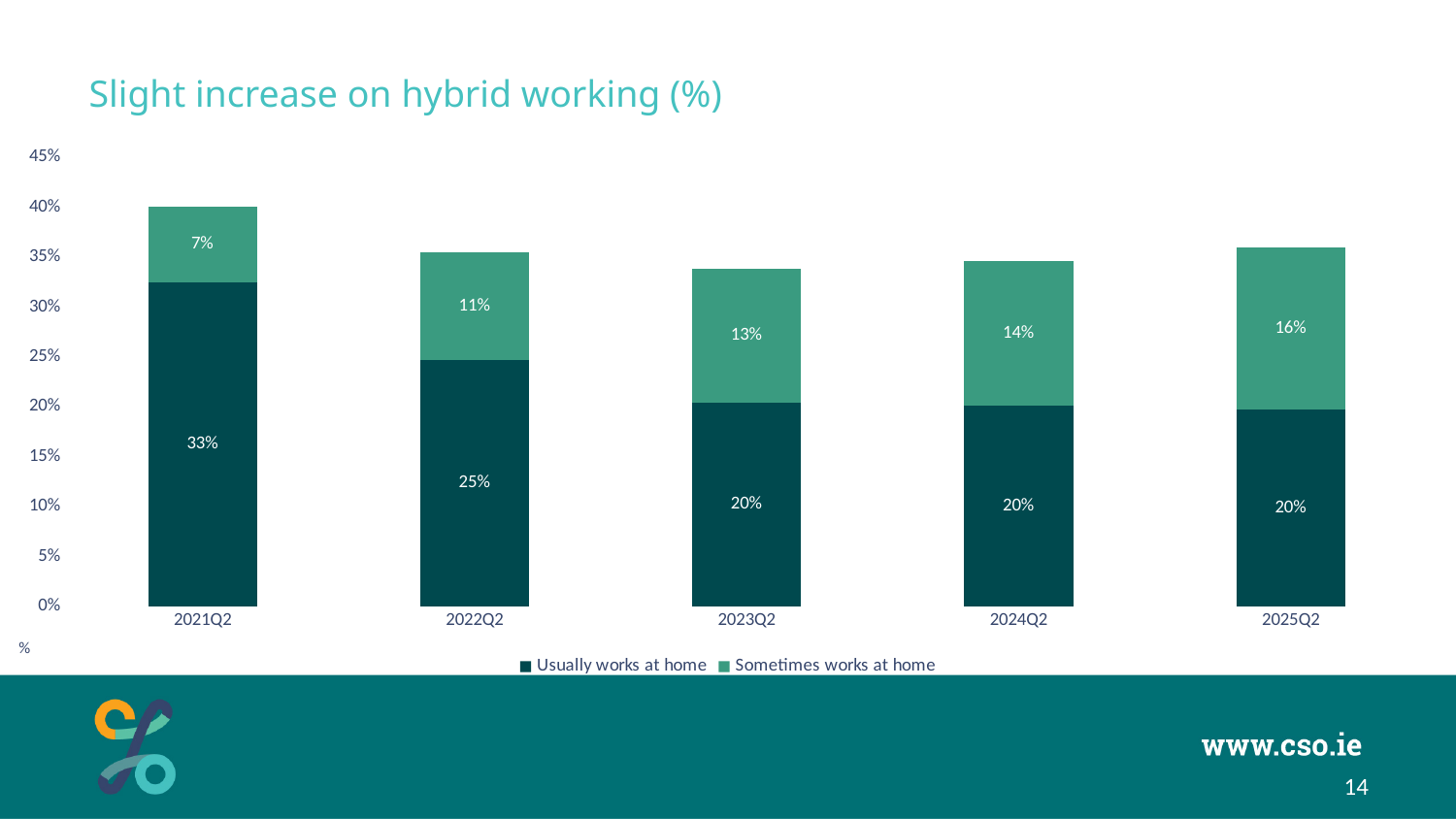
Which quarter has the lowest value for 'Sometimes works at home'? 2021Q2 What is the value for 'Sometimes works at home' in 2022Q2? 11% What is the total of the stacked bar for 2023Q2? 33% How many quarters are shown on the x axis? 5 What is the total of the stacked bar for 2021Q2? 40% What is the difference between the 'Sometimes works at home' values for 2025Q2 and 2021Q2? 9% What is the value for 'Sometimes works at home' in 2025Q2? 16% How many series does the legend list? 2 Which quarter has the highest value for 'Usually works at home'? 2021Q2 Which is larger: 'Usually works at home' in 2022Q2 or 'Sometimes works at home' in 2024Q2? Usually works at home in 2022Q2 What kind of chart is shown on the slide? Stacked bar chart What is the value for 'Usually works at home' in 2021Q2? 33%